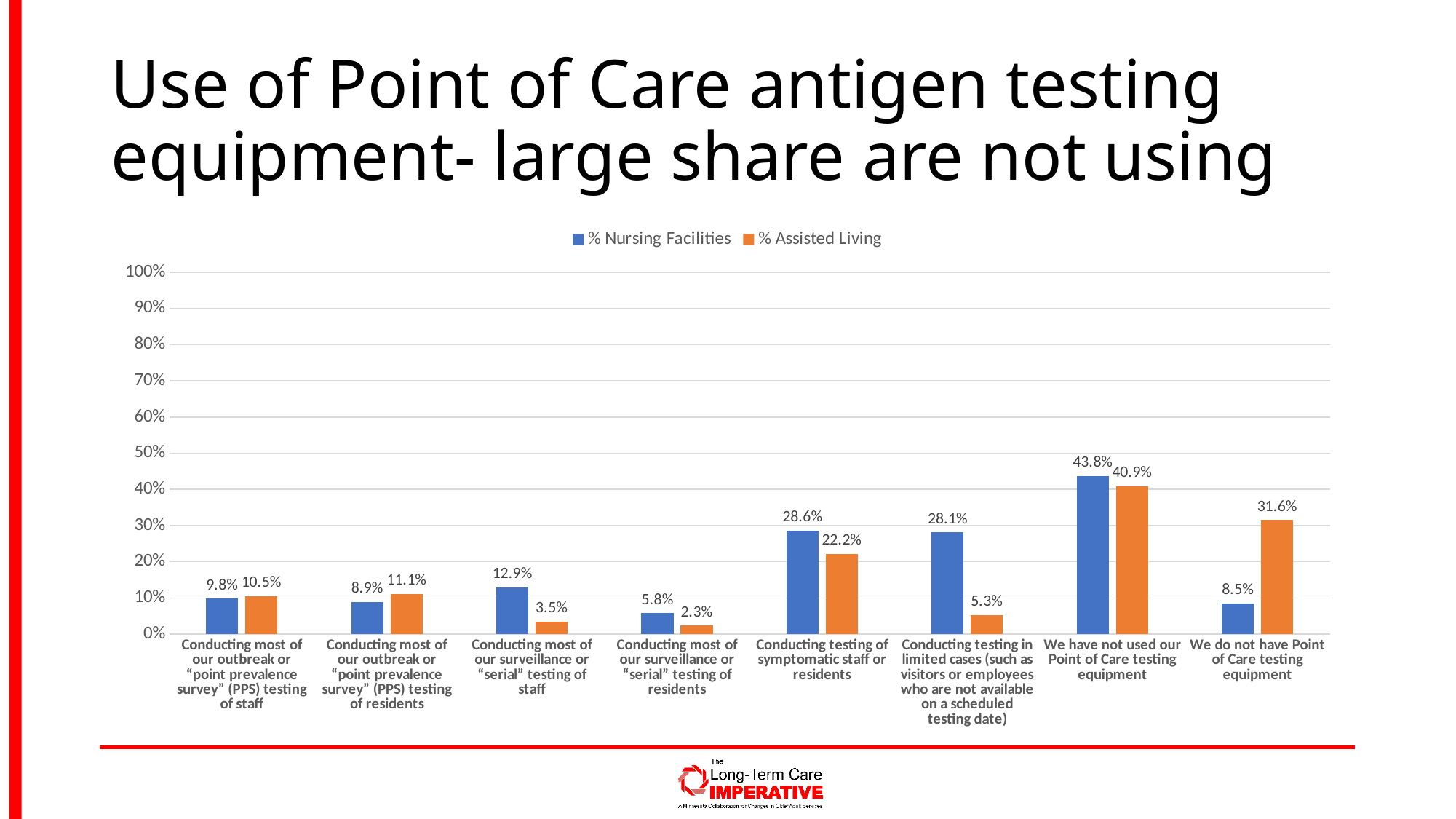
What is the % Assisted Living value for "Conducting testing of symptomatic staff or residents"? 22.2% What colour are the % Assisted Living bars? Orange Is the % Nursing Facilities value for "Conducting testing of symptomatic staff or residents" greater or less than 20%? greater Which category has the lowest % Assisted Living value? Conducting most of our surveillance or "serial" testing of residents For "We do not have Point of Care testing equipment", which series has the larger value: % Nursing Facilities or % Assisted Living? % Assisted Living What is the difference between the % Nursing Facilities and % Assisted Living values for "Conducting testing in limited cases"? 22.8% How many series does the legend list? 2 What is the % Nursing Facilities value for "We have not used our Point of Care testing equipment"? 43.8% Which category has the highest % Nursing Facilities value? We have not used our Point of Care testing equipment How many categories are shown on the x axis of the chart? 8 What is the % Assisted Living value for "We do not have Point of Care testing equipment"? 31.6% What kind of chart is shown on the slide? Bar chart